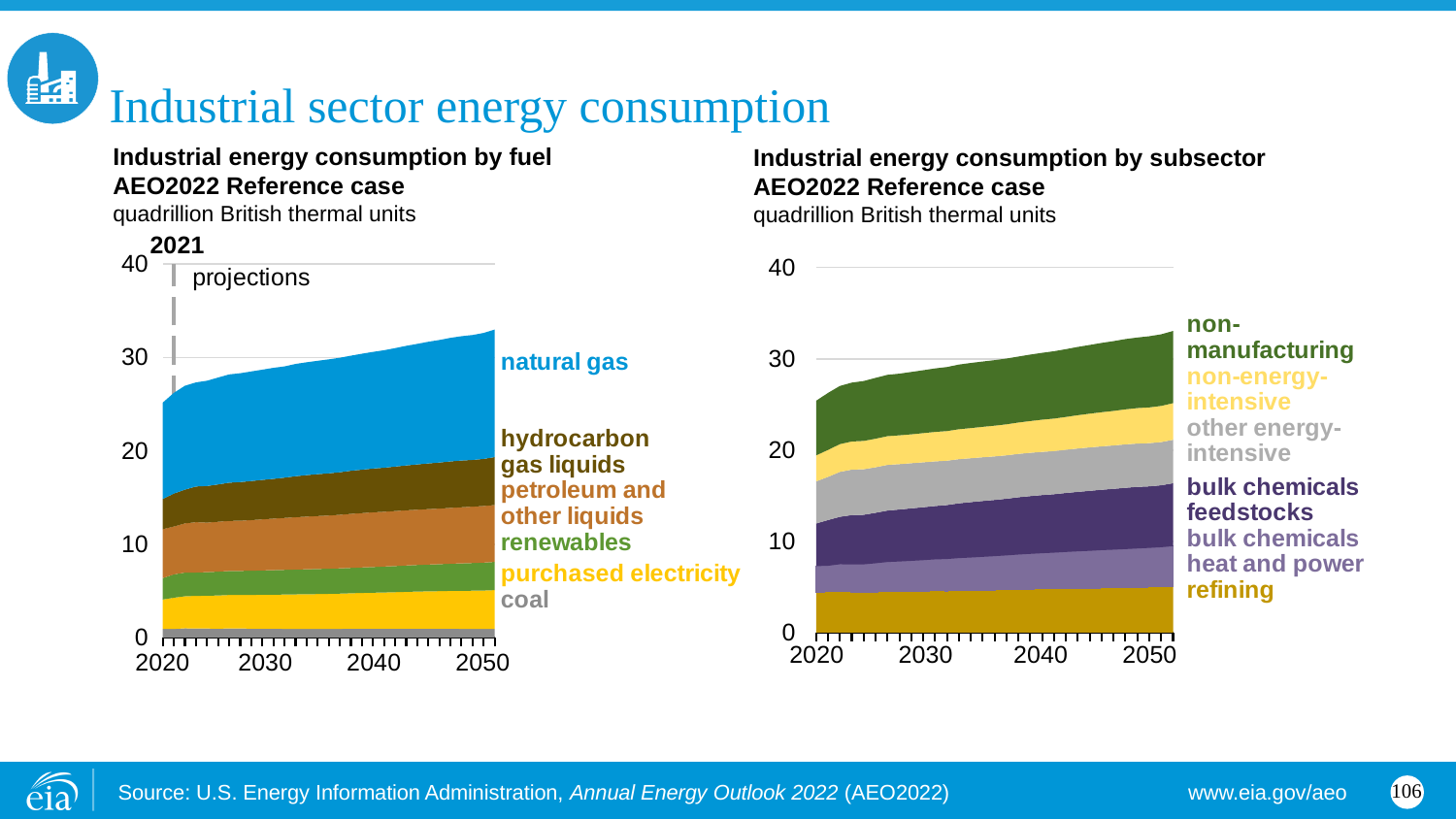
In the 'Industrial energy consumption by fuel' chart on the left, is total consumption in 2020 greater or less than 30 quadrillion British thermal units? less What kind of chart is the 'Industrial energy consumption by fuel' chart on the left? stacked area chart In the 'Industrial energy consumption by fuel' chart on the left, which fuel accounts for the smallest share of consumption? coal How many fuel series are shown in the 'Industrial energy consumption by fuel' chart on the left? 6 In the 'Industrial energy consumption by fuel' chart on the left, which fuel accounts for the largest share of consumption? natural gas In the 'Industrial energy consumption by fuel' chart on the left, does total industrial energy consumption rise or fall from 2020 to 2050? rise In the 'Industrial energy consumption by fuel' chart on the left, is total consumption in 2050 greater or less than 30 quadrillion British thermal units? greater What unit of measurement is used on both charts? quadrillion British thermal units In the 'Industrial energy consumption by fuel' chart on the left, what year does the dashed vertical line marking the start of projections correspond to? 2021 How many subsector series are shown in the 'Industrial energy consumption by subsector' chart on the right? 6 In the 'Industrial energy consumption by subsector' chart on the right, which is larger in 2050: non-manufacturing or refining? non-manufacturing In the 'Industrial energy consumption by subsector' chart on the right, is total consumption in 2050 greater or less than 30 quadrillion British thermal units? greater